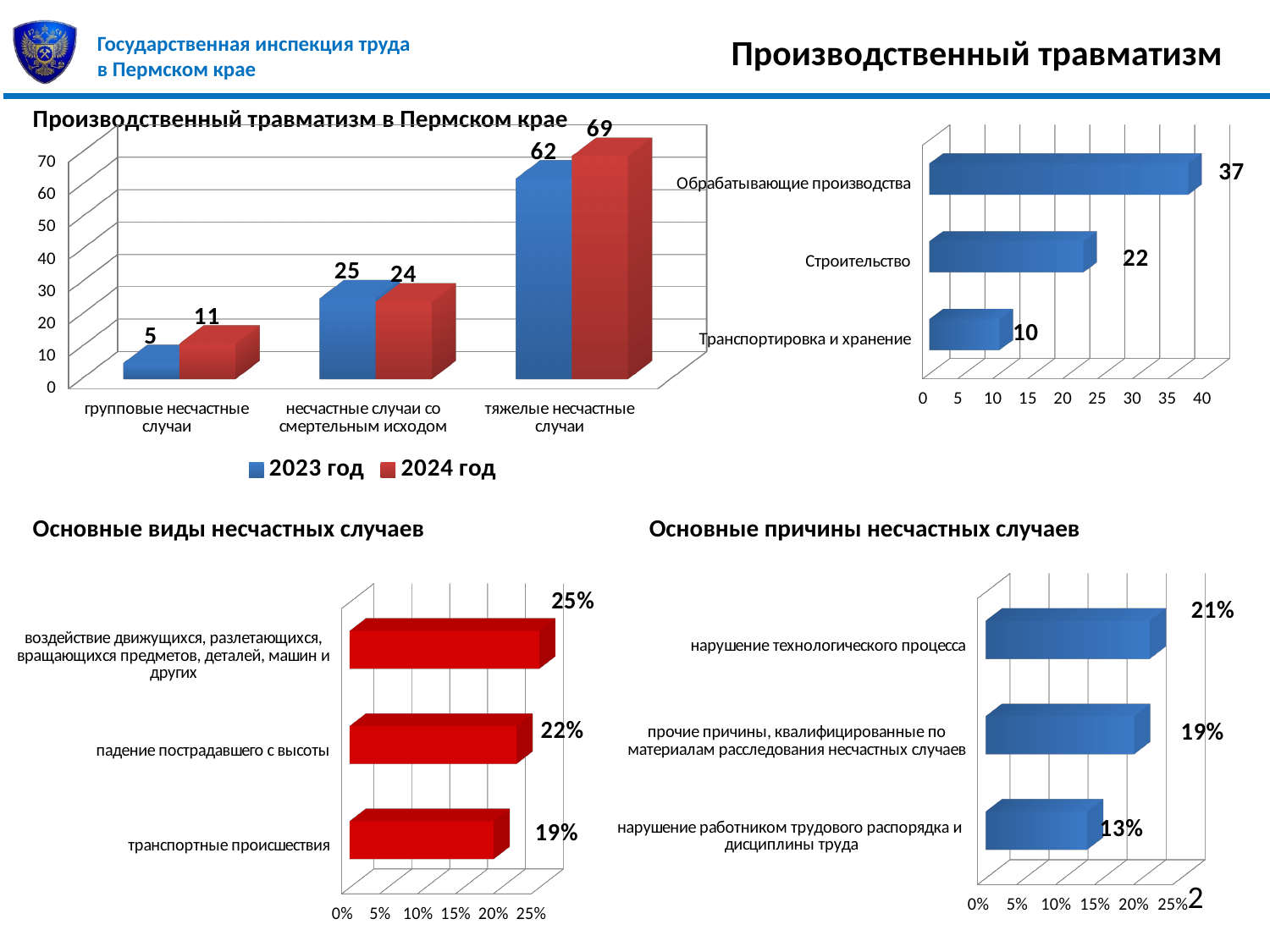
In the top-right chart, which category has the lowest value? Транспортировка и хранение In the top-right chart, what is the value for 'Обрабатывающие производства'? 37 In the chart 'Основные причины несчастных случаев', which category has the highest value? нарушение технологического процесса In the top-right chart, what is the difference between 'Обрабатывающие производства' and 'Строительство'? 15 In the chart 'Производственный травматизм в Пермском крае', what is the value for 'групповые несчастные случаи' in 2023 год? 5 What kind of chart is 'Основные причины несчастных случаев'? bar chart In the chart 'Производственный травматизм в Пермском крае', which is larger for 'несчастные случаи со смертельным исходом': 2023 год or 2024 год? 2023 год In the chart 'Производственный травматизм в Пермском крае', what is the value for 'тяжелые несчастные случаи' in 2024 год? 69 In the chart 'Производственный травматизм в Пермском крае', which category has the highest value in 2023 год? тяжелые несчастные случаи In the chart 'Основные виды несчастных случаев', what is the value for 'падение пострадавшего с высоты'? 22% In the chart 'Производственный травматизм в Пермском крае', what is the difference between the 2024 год and 2023 год values for 'тяжелые несчастные случаи'? 7 In the chart 'Производственный травматизм в Пермском крае', how many series does the legend list? 2